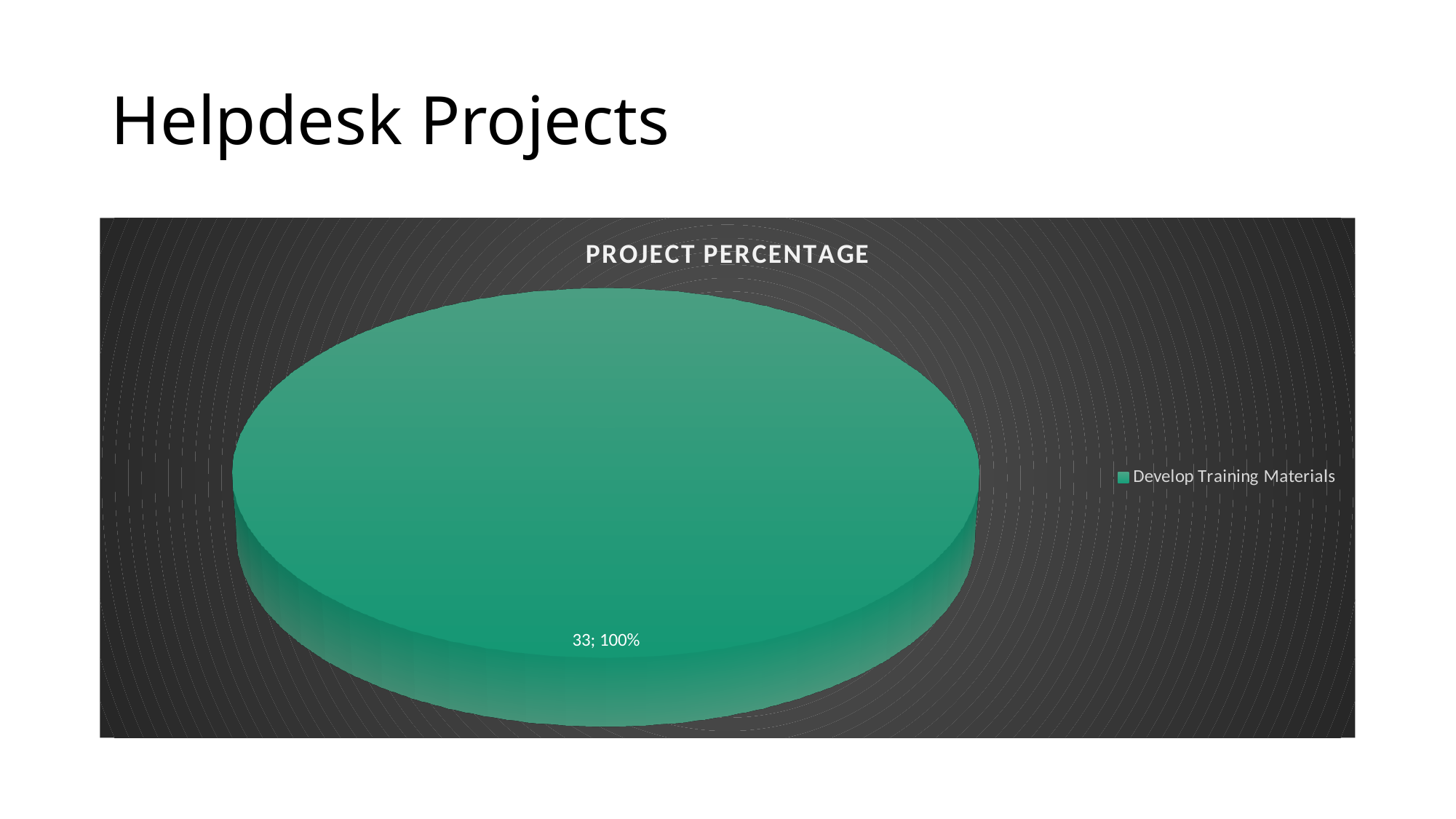
What share of the pie does Develop Training Materials represent? 100% What is the title of the chart? PROJECT PERCENTAGE Is the value for Develop Training Materials greater or less than 30? greater How many categories does the legend list? 1 What is the value shown for Develop Training Materials? 33 How many slices does the pie chart have? 1 What kind of chart is shown on the slide? pie chart Which category is listed in the legend? Develop Training Materials